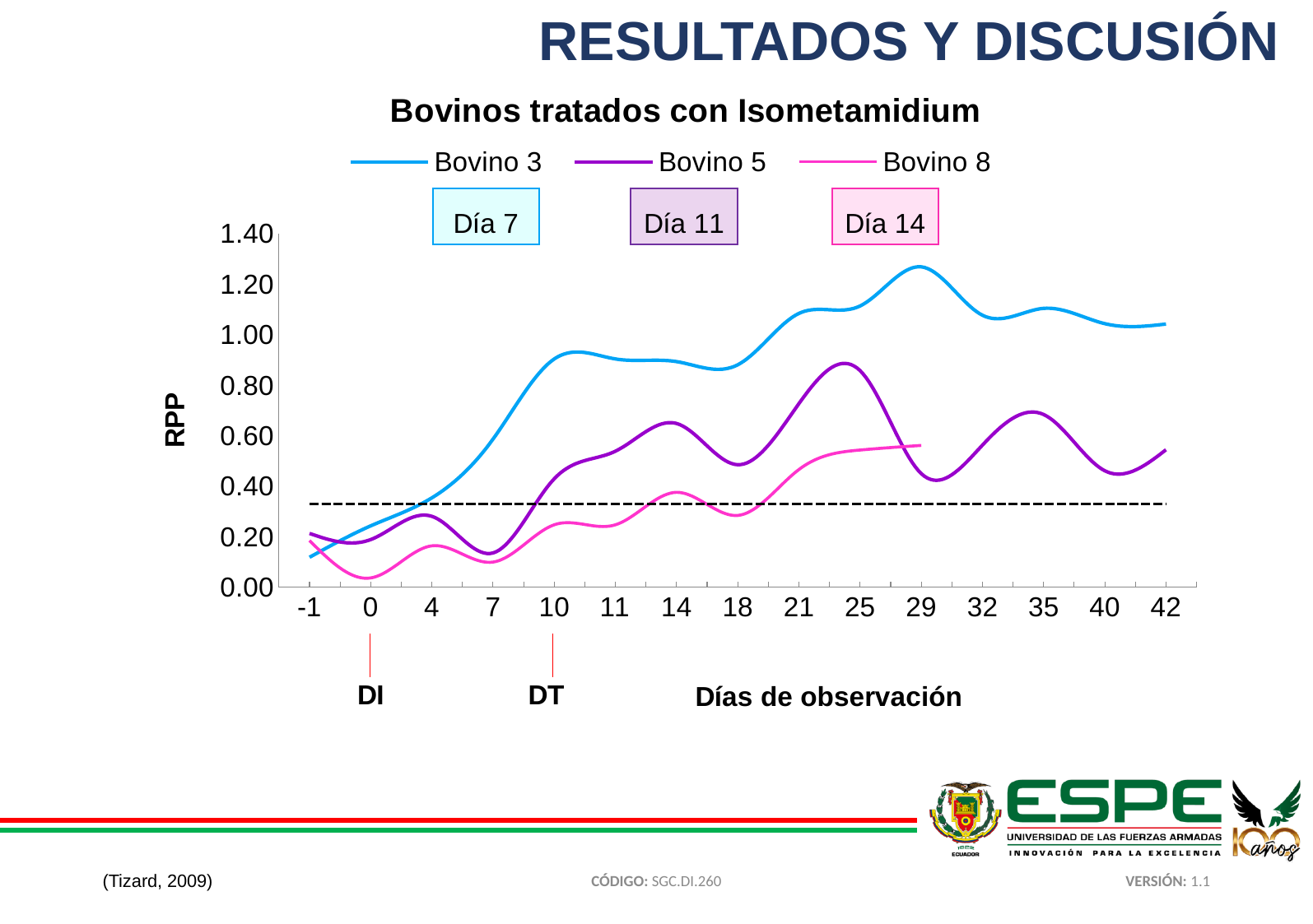
Is the value for Bovino 3 at day 29 greater or less than 1.00? greater Is the value for Bovino 8 at day 0 greater or less than 0.20? less Is the value for Bovino 5 at day 29 greater or less than 0.60? less Which series reaches the highest RPP value in the chart? Bovino 3 How many series does the legend list? 3 What kind of chart is shown on the slide? line chart At day 42, which series has the larger value, Bovino 3 or Bovino 5? Bovino 3 What is the title of the chart? Bovinos tratados con Isometamidium Does the Bovino 3 line rise or fall between day -1 and day 10? rise How many observation days are marked along the x axis? 15 What is the label of the vertical axis? RPP